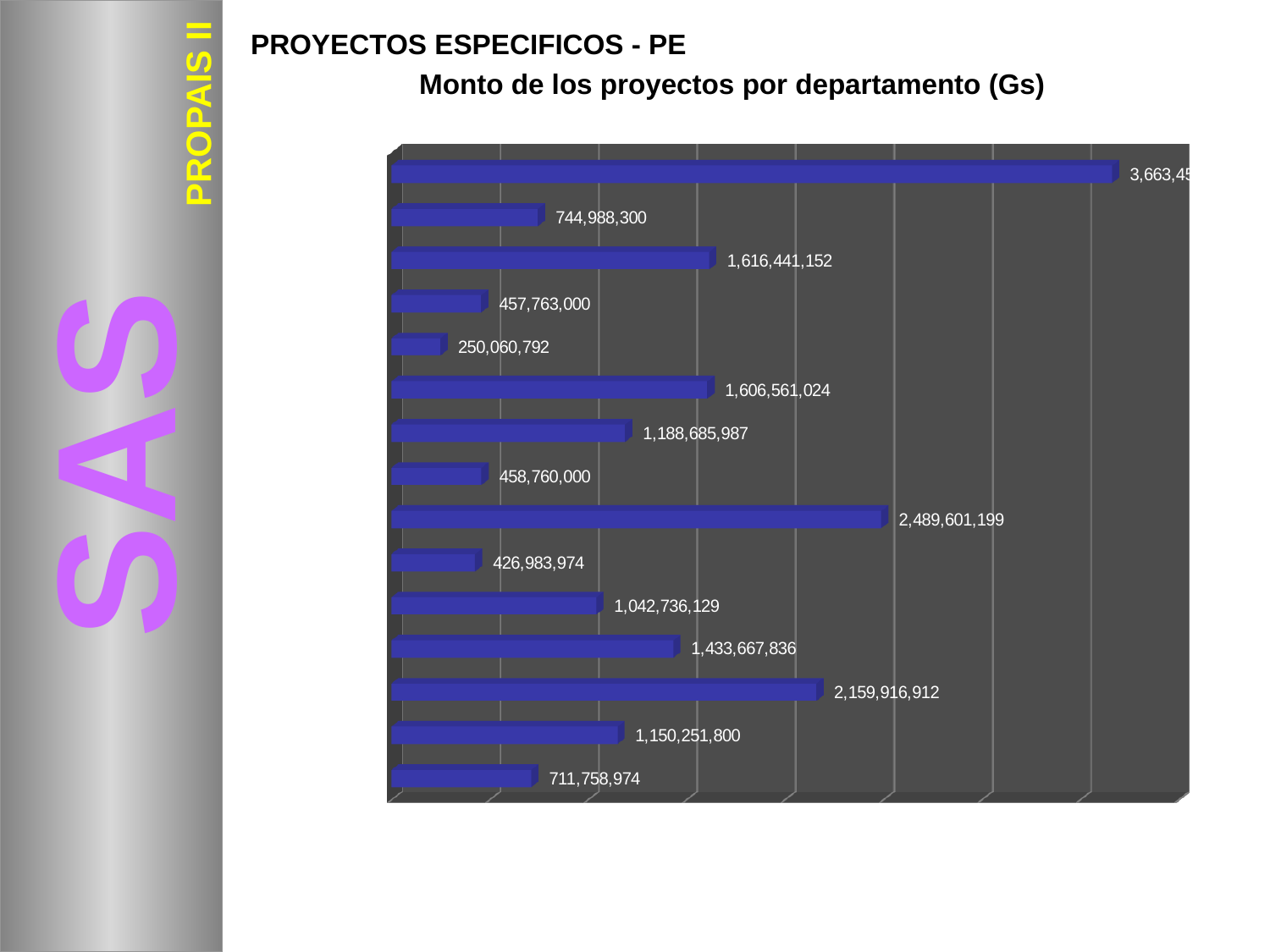
What is the smallest value labelled on the chart? 250,060,792 Which is larger: the value on the second bar from the top (744,988,300) or the value on the bottom bar (711,758,974)? 744,988,300 What is the difference between the value on the second bar from the top and the value on the bottom bar? 33,229,326 What is the difference between the bar labelled 2,489,601,199 and the bar labelled 2,159,916,912? 329,684,287 What is the value shown on the ninth bar from the top? 2,489,601,199 What is the title of the chart? Monto de los proyectos por departamento (Gs) What kind of chart is shown on the slide? bar chart How many bars does the chart contain? 15 What is the value shown on the bottom bar of the chart? 711,758,974 What is the value shown on the second bar from the top? 744,988,300 Which bar is the longest in the chart? the top bar What is the value shown on the fifth bar from the top? 250,060,792